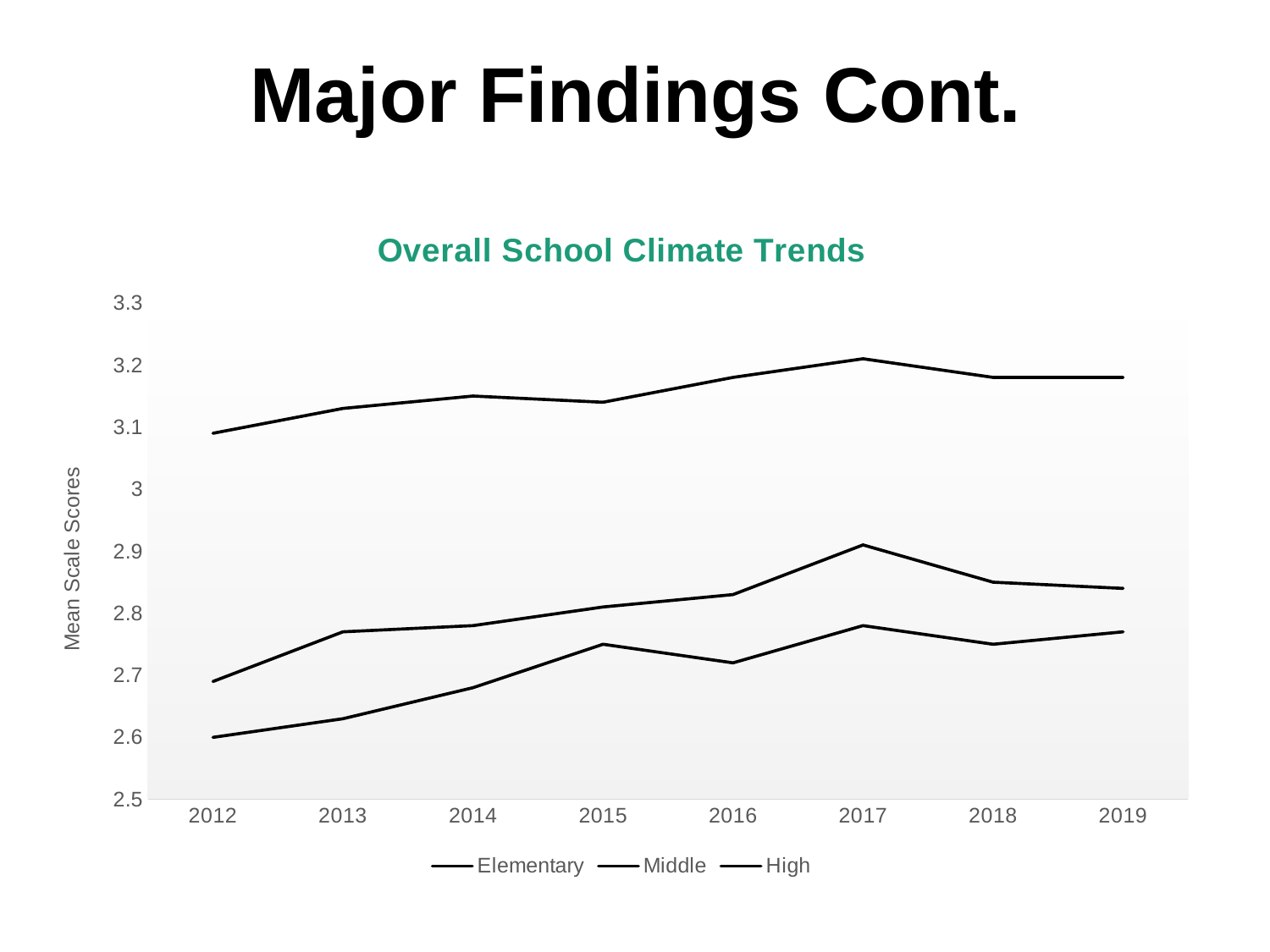
What is the title of the chart? Overall School Climate Trends In which year does the topmost line reach its highest point? 2017 What are the series names listed in the legend? Elementary, Middle, High In which year is the lowest line at its lowest point? 2012 How many years are shown along the x axis? 8 How many series does the legend list? 3 What kind of chart is shown on the slide? line chart Is the value of the topmost line in 2012 greater or less than 3? greater Is the value of the lowest line in 2012 greater or less than 2.7? less Does the topmost line generally rise or fall from 2012 to 2017? rise What is the label of the y axis? Mean Scale Scores